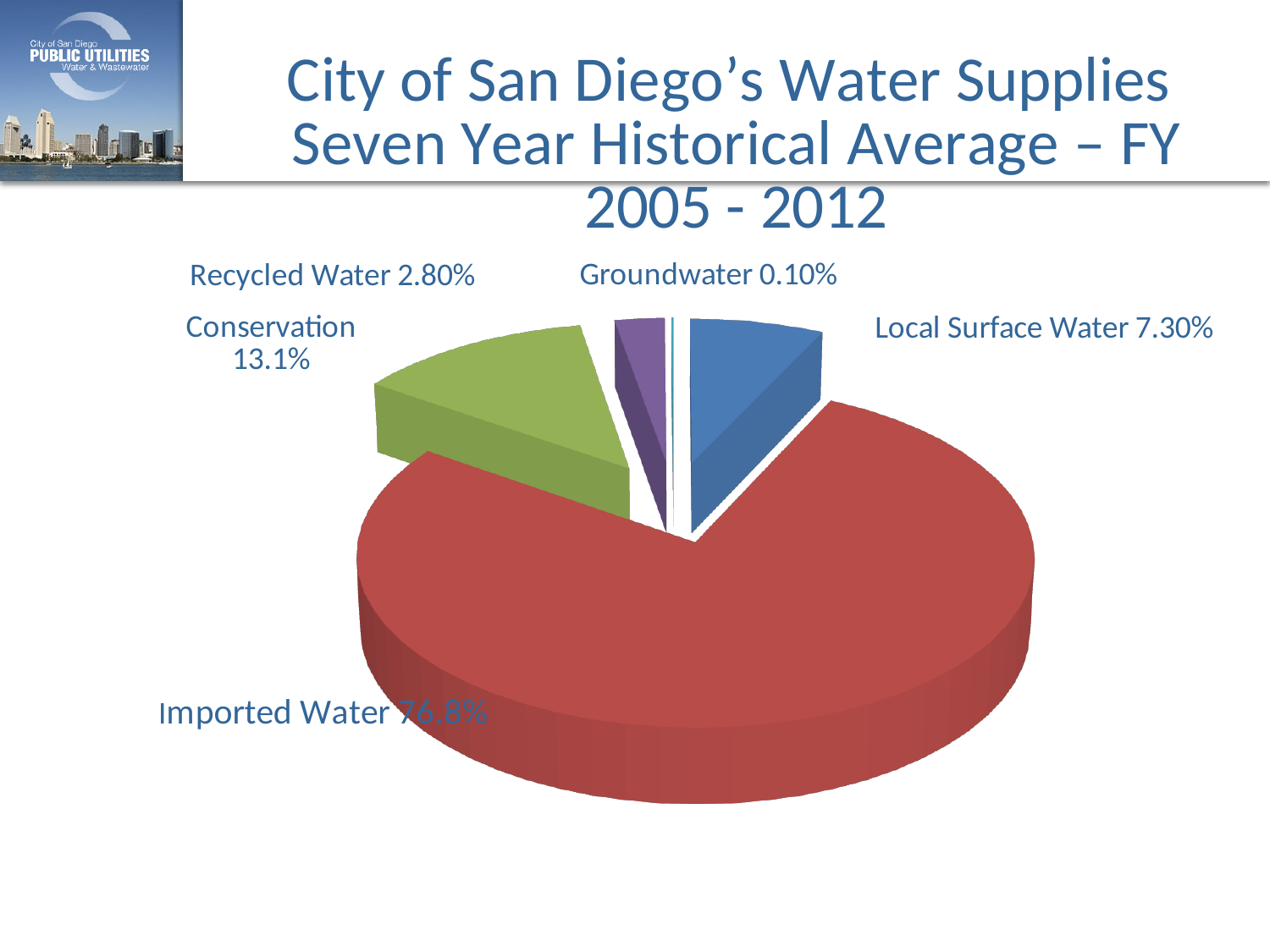
What kind of chart is shown on the slide? Pie chart What share of the City of San Diego's water supplies is Imported Water? 76.8% Which water supply source has the largest share of the pie? Imported Water What percentage is shown for Groundwater? 0.10% What colour is the Imported Water slice? Red What is the difference in percentage points between Imported Water and Conservation? 63.7 What percentage is shown for Recycled Water? 2.80% What percentage is shown for Conservation? 13.1% Which water supply source has the smallest share of the pie? Groundwater Which is larger, the share for Conservation or the share for Local Surface Water? Conservation How many slices does the pie chart have? 5 What percentage is shown for Local Surface Water? 7.30%